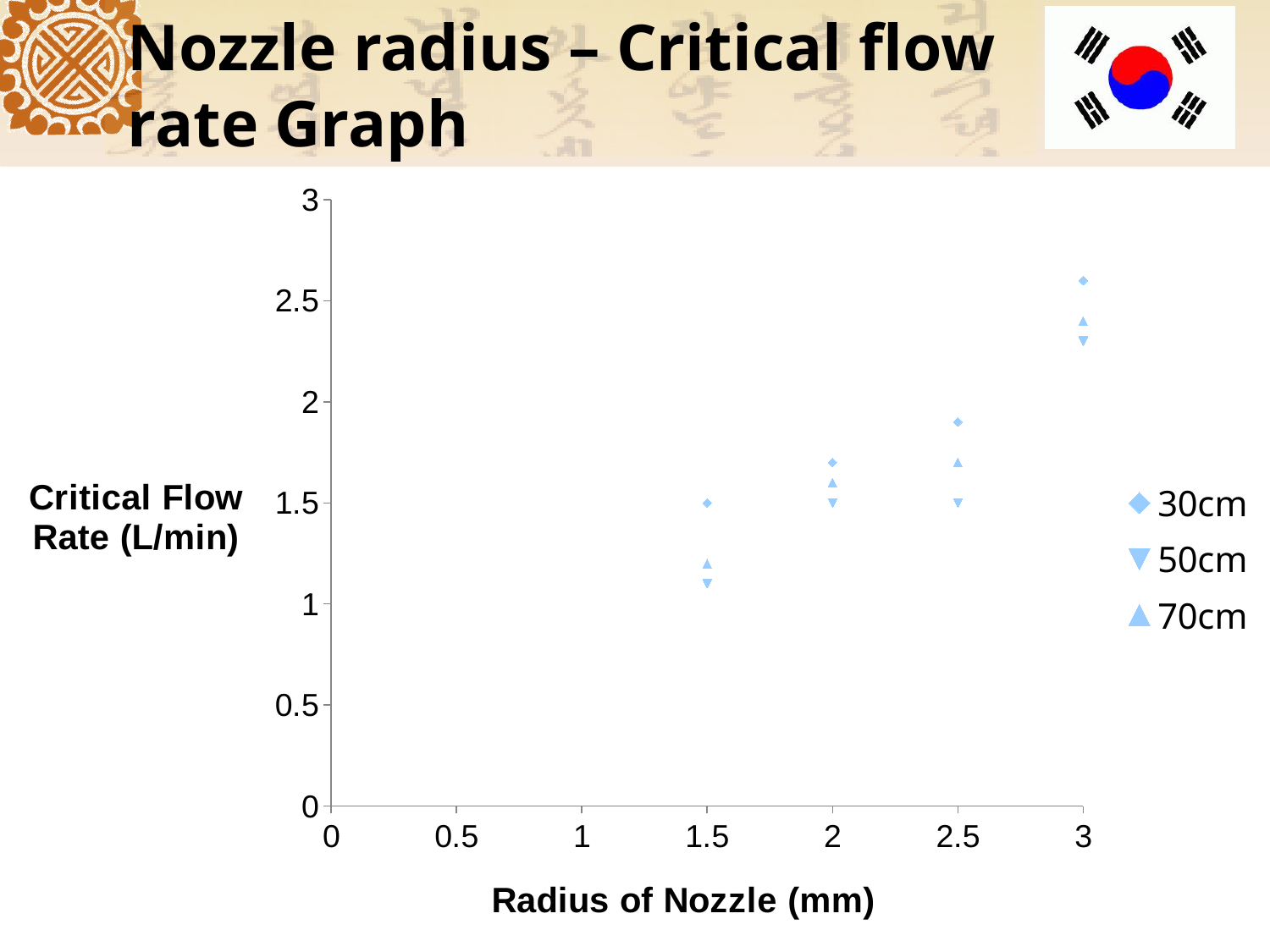
Is the value for the 50cm series at a nozzle radius of 3 mm greater or less than 2? greater Is the value for the 70cm series at a nozzle radius of 2.5 mm greater or less than 1.5? greater Is the value for the 30cm series at a nozzle radius of 3 mm greater or less than 2? greater What is the title of the x axis? Radius of Nozzle (mm) What is the critical flow rate for the 30cm series at a nozzle radius of 1.5 mm? 1.5 At a nozzle radius of 3 mm, which series has the highest critical flow rate? 30cm At a nozzle radius of 3 mm, which series has the higher critical flow rate, 30cm or 50cm? 30cm Do the critical flow rate values rise or fall as the nozzle radius increases? rise How many series does the legend list? 3 What kind of chart is shown on the slide? scatter chart At how many nozzle radius values are points plotted for each series? 4